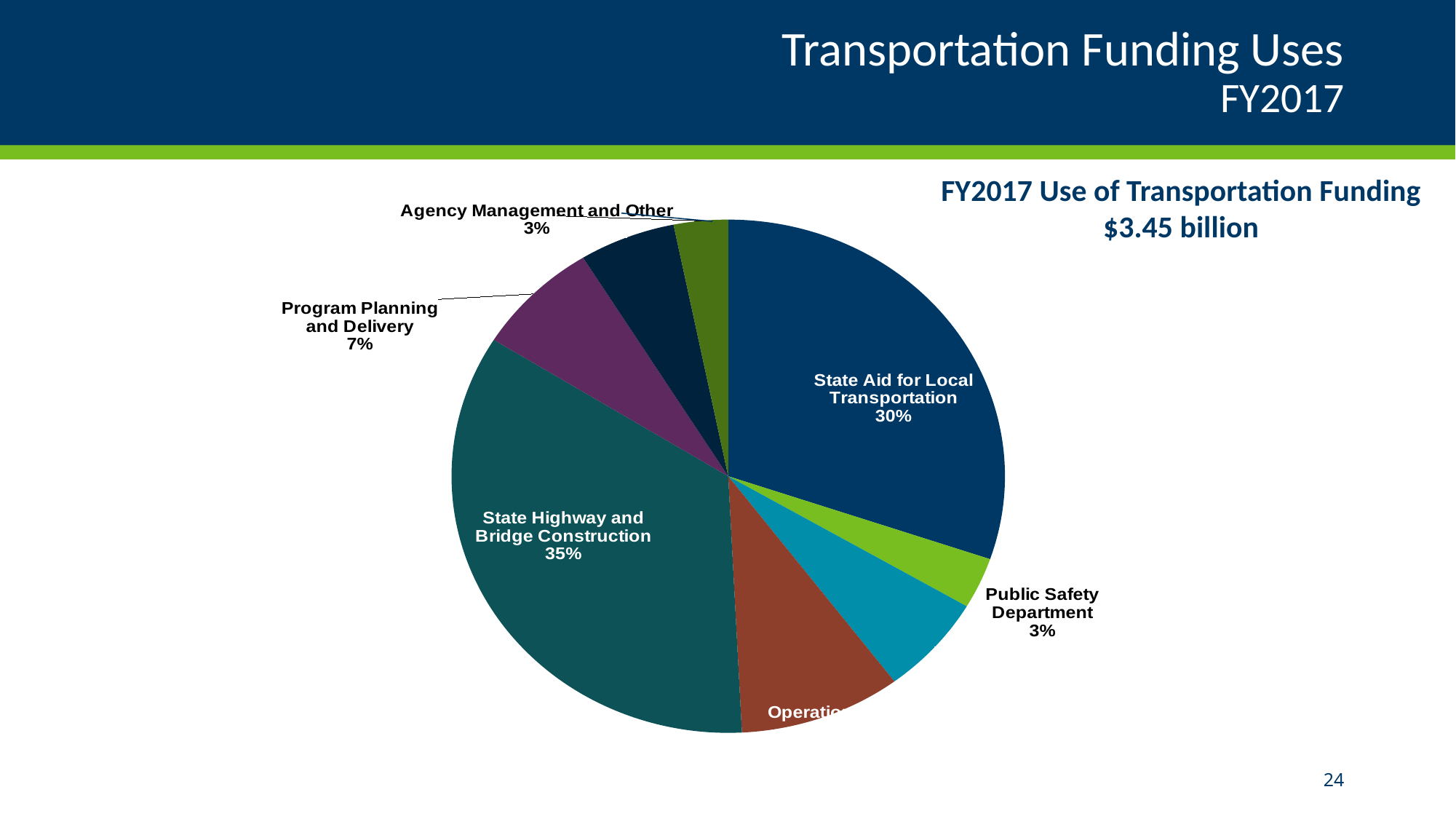
What share is labelled for Program Planning and Delivery? 7% How many slices does the pie chart have? 8 What total dollar amount of transportation funding does the chart title state for FY2017? $3.45 billion Which labelled category has the largest share of the pie? State Highway and Bridge Construction What share of funding goes to the Public Safety Department? 3% What percentage of the pie is State Aid for Local Transportation? 30% What kind of chart is shown on the slide? Pie chart Which is larger: State Aid for Local Transportation or State Highway and Bridge Construction? State Highway and Bridge Construction What percentage is shown for Agency Management and Other? 3% What is the difference in percentage points between Program Planning and Delivery and Agency Management and Other? 4 percentage points What share of FY2017 transportation funding goes to State Highway and Bridge Construction? 35% How many percentage points larger is State Highway and Bridge Construction than State Aid for Local Transportation? 5 percentage points